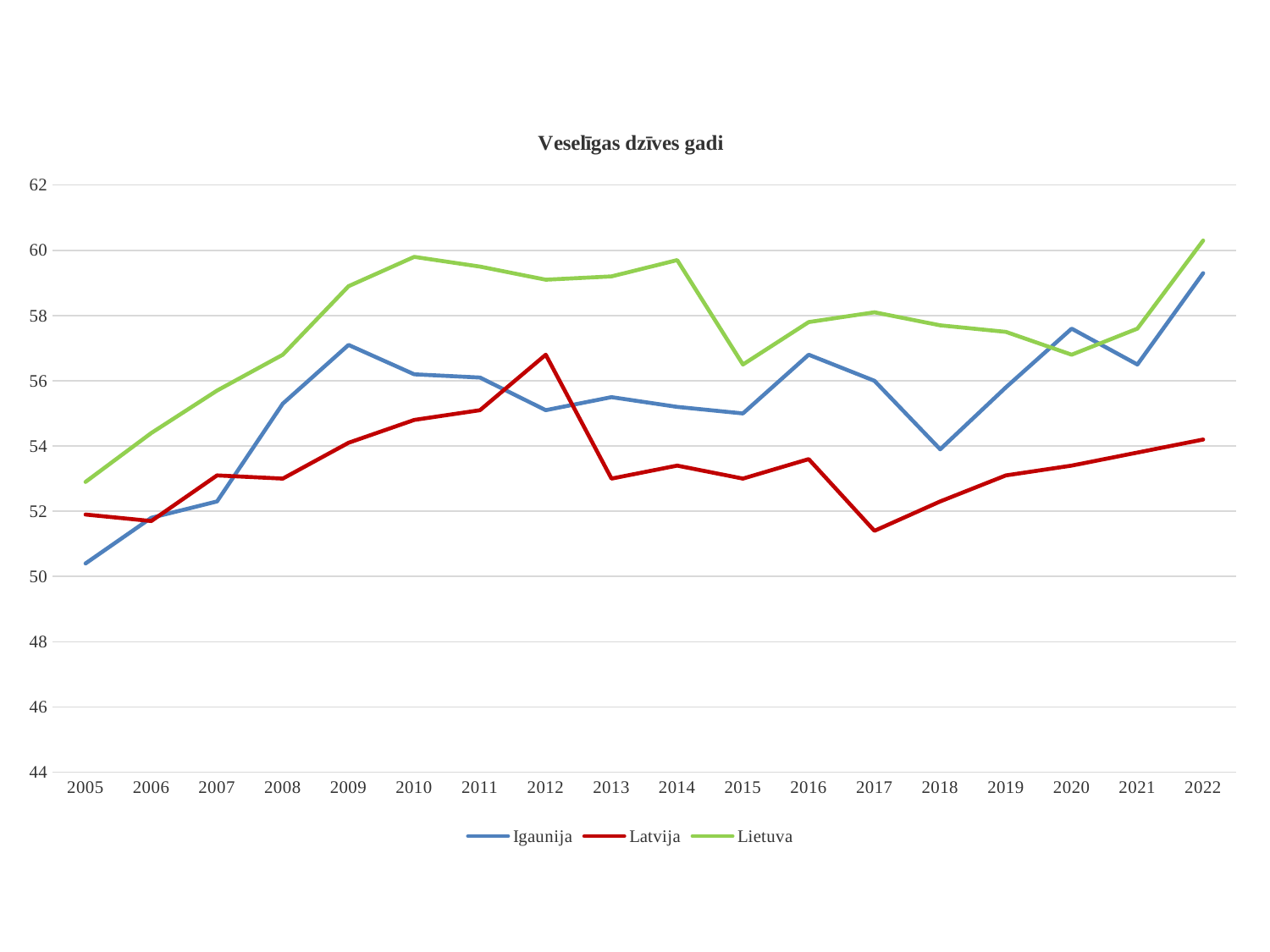
How many years are plotted along the x axis? 18 Is the value for Igaunija in 2005 greater or less than 52? less In which year does Latvija reach its lowest value? 2017 What kind of chart is shown on the slide? line chart Is the value for Igaunija in 2009 greater or less than 56? greater How many series does the legend list? 3 Which series is shown with the green line? Lietuva Does the Latvija line rise or fall from 2017 to 2022? rise Which series has the highest value in 2022? Lietuva In 2012, which is higher: Latvija or Igaunija? Latvija What is the title of the chart? Veselīgas dzīves gadi Is the value for Latvija in 2017 greater or less than 52? less